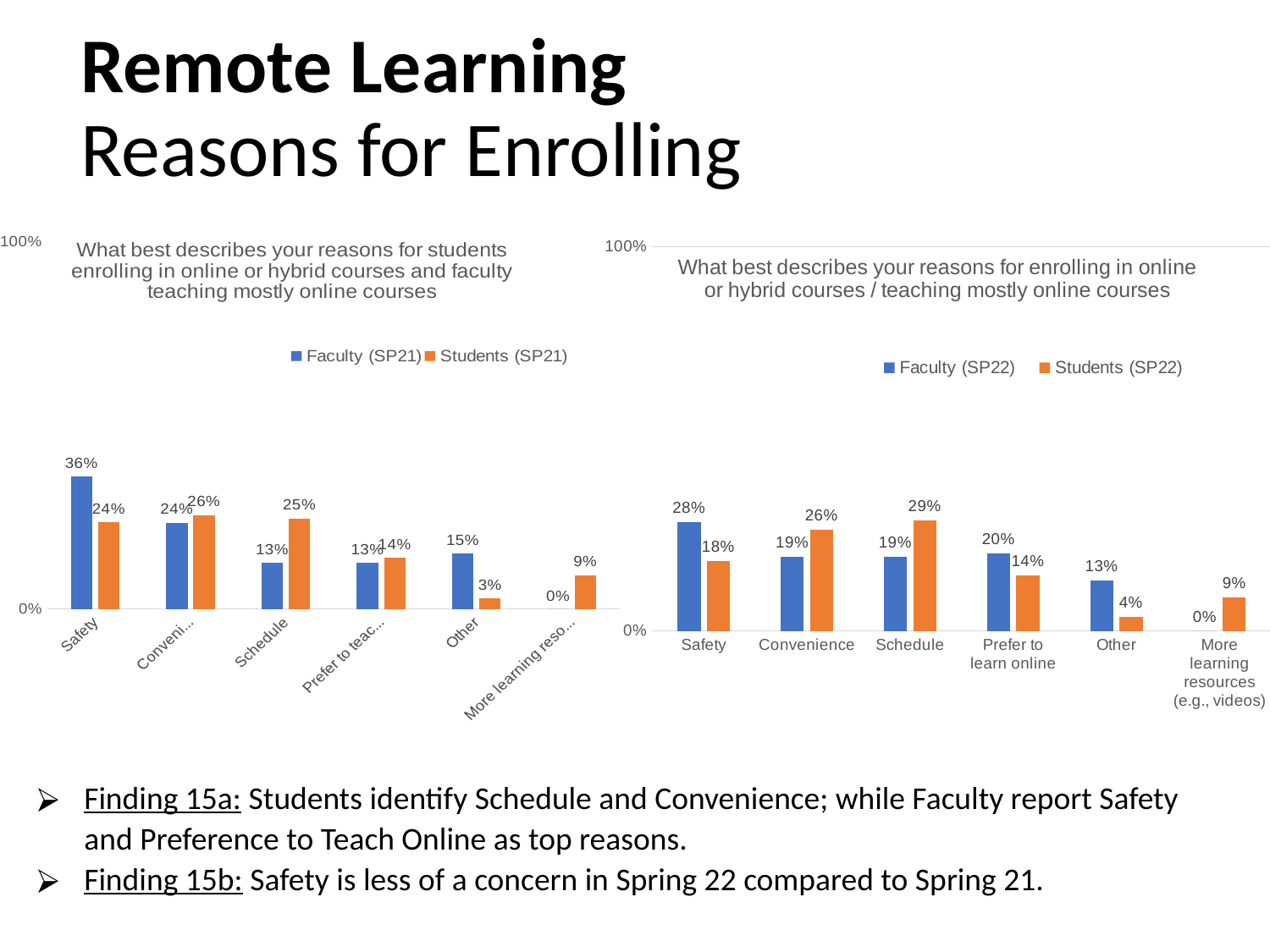
In the right chart (SP22), what is the value for Faculty for Safety? 28% In the right chart (SP22), what is the value for Students for Schedule? 29% In the right chart (SP22), which is larger for Convenience, the Faculty value or the Students value? Students In the right chart (SP22), which category has the lowest Faculty value? More learning resources (e.g., videos) In the left chart (SP21), what is the value for Faculty for Safety? 36% How many categories are shown on the x axis of the right chart (SP22)? 6 How many series does the legend of the left chart (SP21) list? 2 In the right chart (SP22), what is the difference between the Faculty and Students values for Safety? 10% In the left chart (SP21), what is the value for Students for Other? 3% What type of chart is the right chart (SP22)? Bar chart In the right chart (SP22), which category has the highest Students value? Schedule In the left chart (SP21), what is the difference between the Faculty and Students values for Schedule? 12%